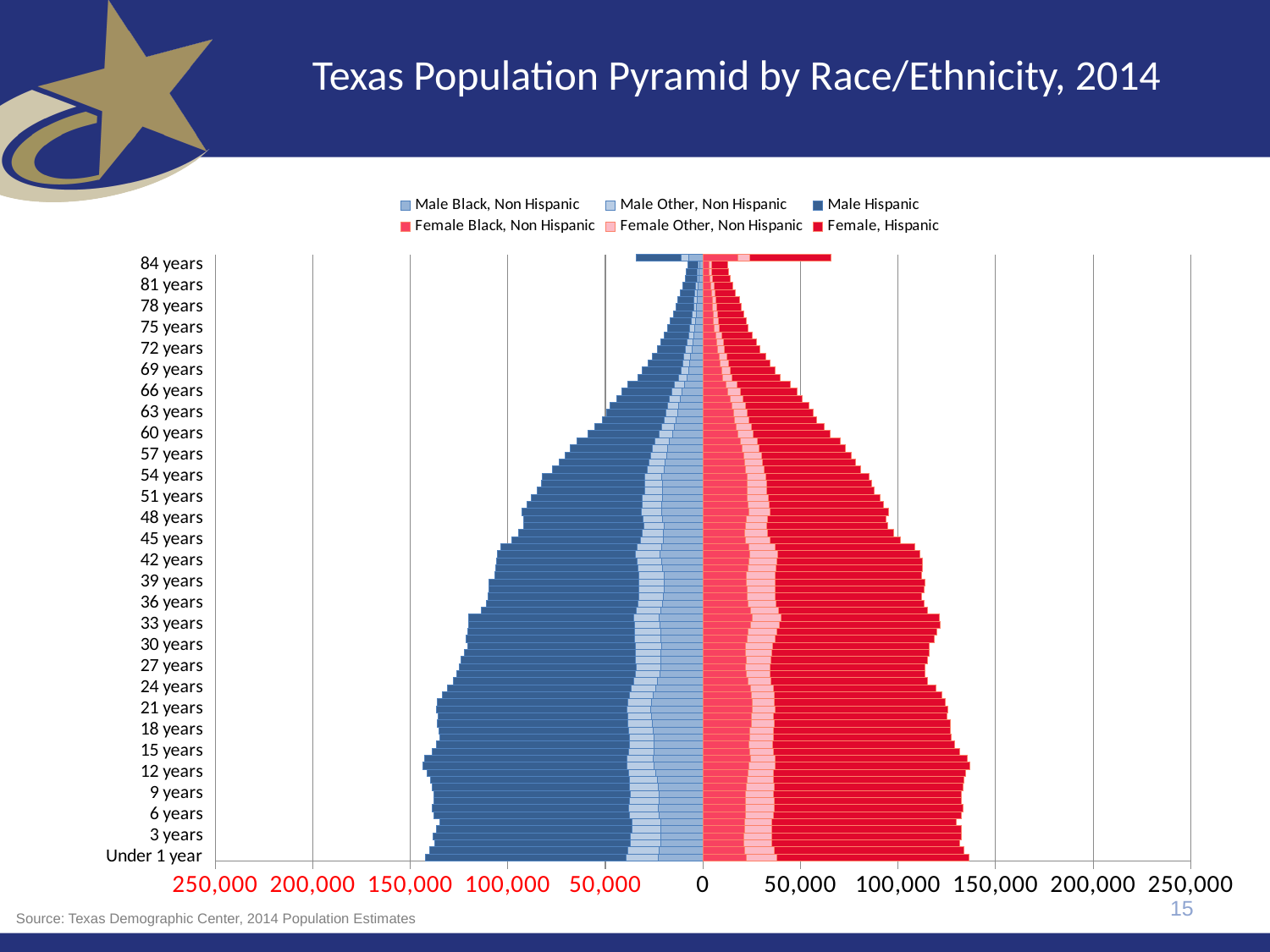
Is the total male population bar for 12 years greater or less than 100,000? greater Which has the longer total female bar, 33 years or 60 years? 33 years Do the total population bars generally get longer or shorter as age increases from Under 1 year to 84 years? shorter Is the total female population bar for 72 years greater or less than 50,000? less Which legend entry is shown in dark blue? Male Hispanic Which has the longer total male bar, 12 years or 84 years? 12 years Is the total female population bar for 33 years greater or less than 100,000? greater What kind of chart is shown on the slide? bar chart How many series does the legend list? 6 What is the title of the chart? Texas Population Pyramid by Race/Ethnicity, 2014